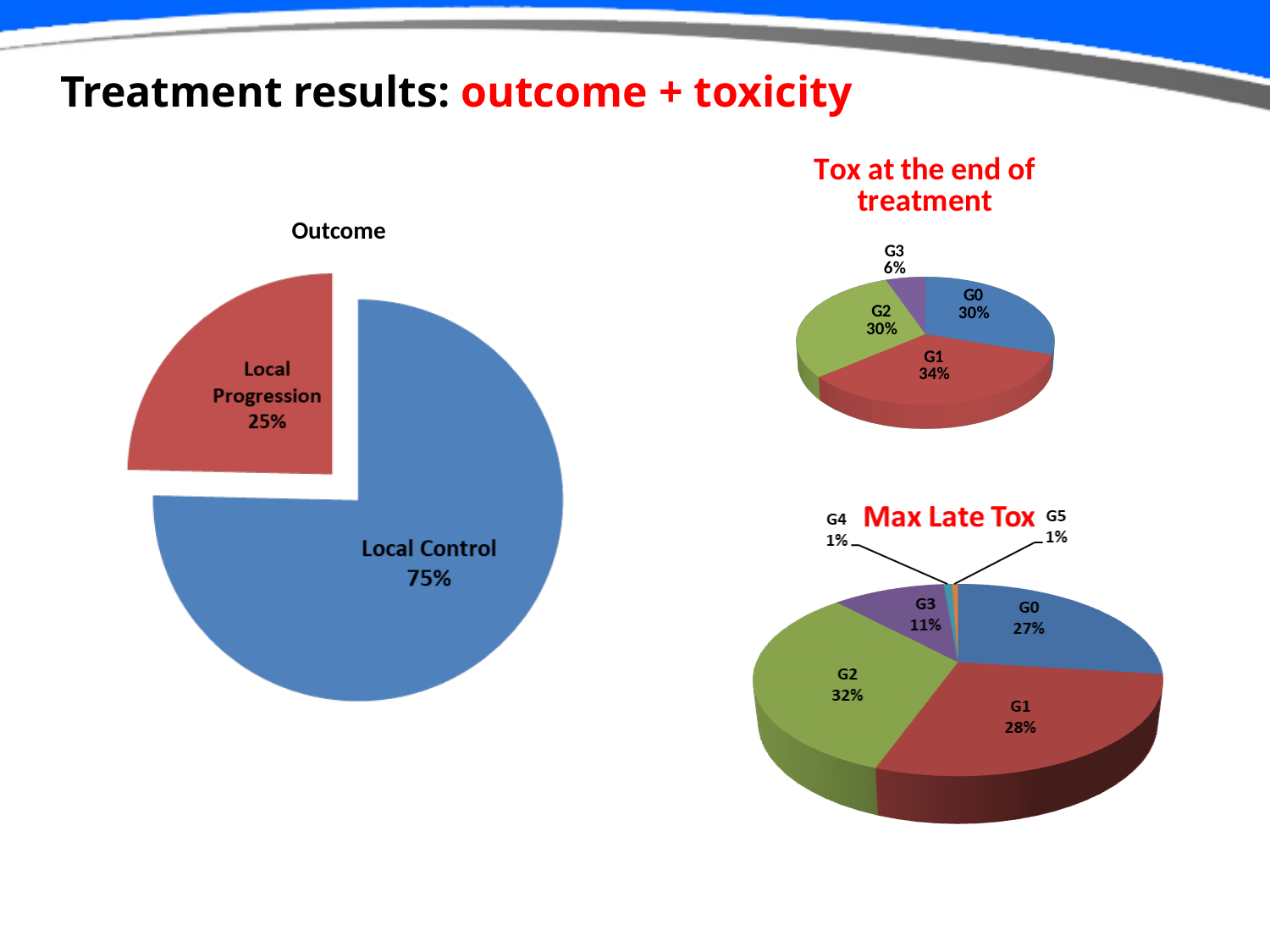
In the Tox at the end of treatment chart, which grade has the smallest share? G3 In the Max Late Tox chart, which grade has the largest share? G2 In the Max Late Tox chart, which is larger, G0 or G1? G1 In the Max Late Tox chart, how many grade categories are shown? 6 In the Max Late Tox chart, what is the value for G3? 11% What kind of chart is the Outcome chart? Pie chart In the Outcome chart, what is the value for Local Progression? 25% In the Tox at the end of treatment chart, what is the difference between G1 and G3? 28% In the Outcome chart, how many slices are there? 2 In the Tox at the end of treatment chart, what is the value for G1? 34% In the Tox at the end of treatment chart, how many grade categories are shown? 4 In the Outcome chart, what share does Local Control have? 75%